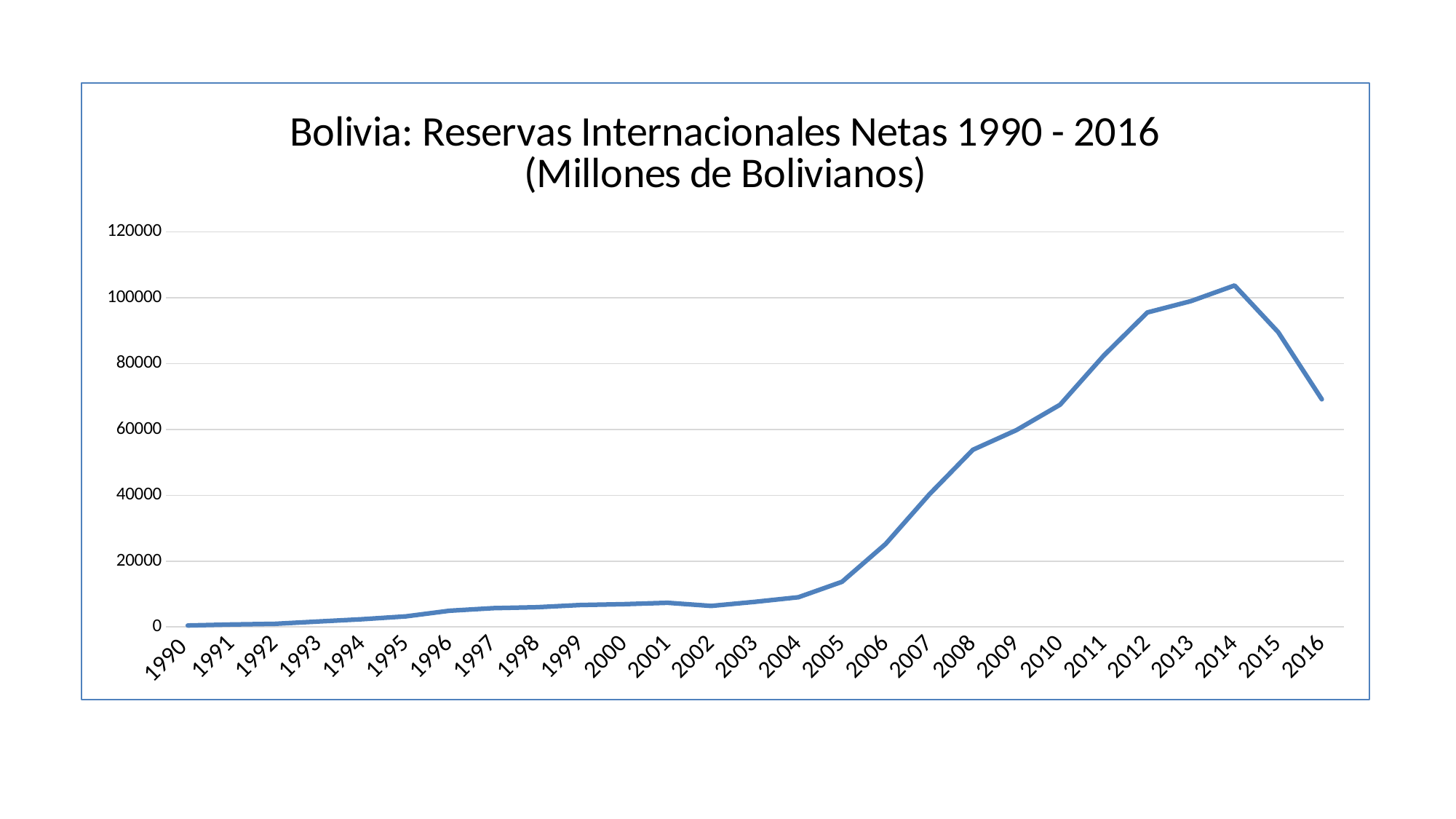
Which year has the larger value, 2014 or 2016? 2014 In which year do the net international reserves reach their highest value? 2014 Do the values rise or fall from 2005 to 2014? rise Is the value for 2012 greater or less than 80000? greater What kind of chart is shown on the slide? line chart Is the value for 2014 greater or less than 100000? greater How many years are plotted along the x axis? 27 Is the value for 2005 greater or less than 20000? less What is the title of the chart? Bolivia: Reservas Internacionales Netas 1990 - 2016 (Millones de Bolivianos) Do the values rise or fall from 2014 to 2016? fall